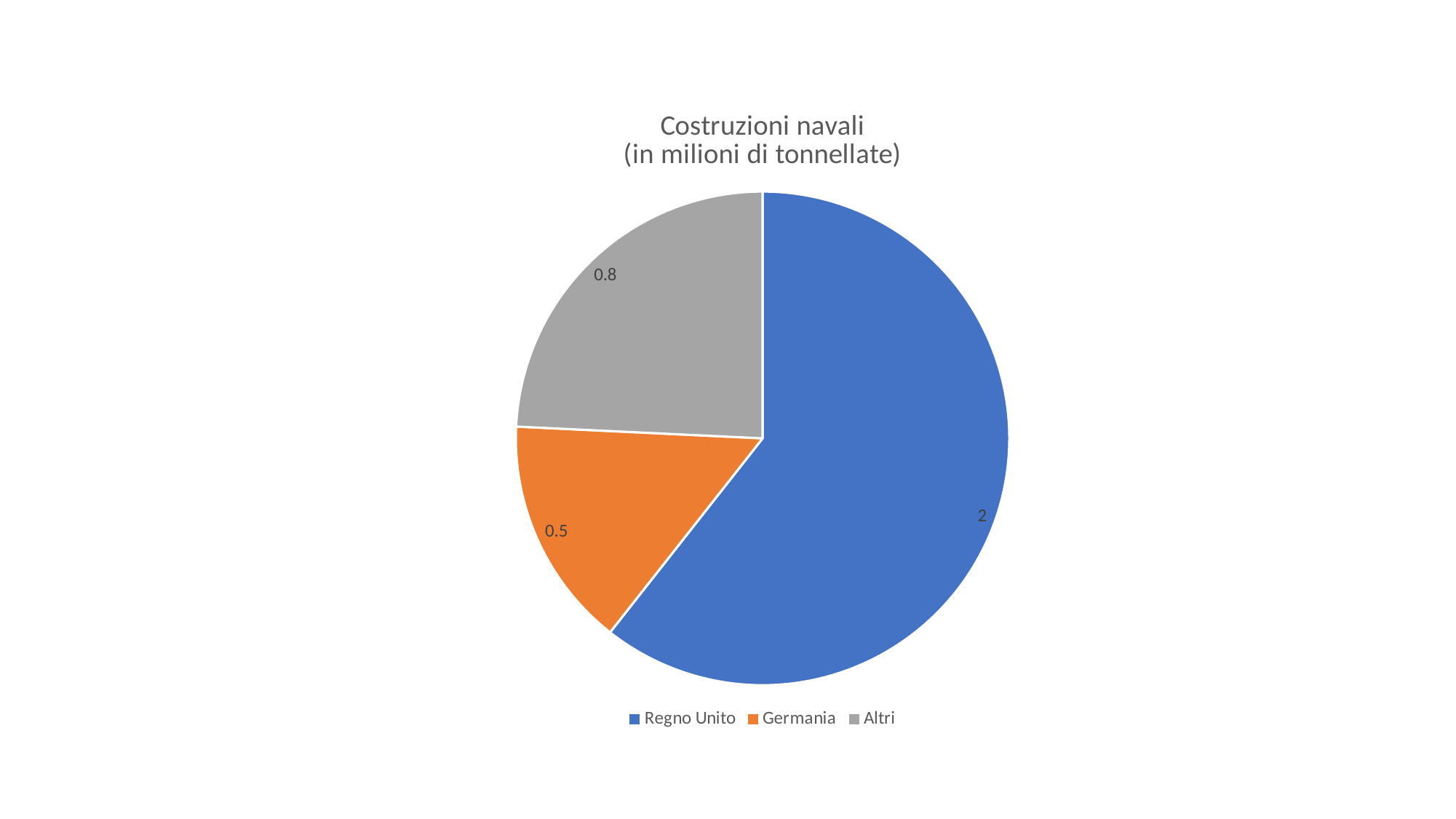
What is the total of all slices in the pie chart? 3.3 How many slices does the pie chart have? 3 Which category has the smallest slice? Germania What is the value for Altri? 0.8 What is the title of the chart? Costruzioni navali (in milioni di tonnellate) What kind of chart is shown on the slide? Pie chart What is the value for Germania? 0.5 What is the difference between the values for Altri and Germania? 0.3 Which category has the largest slice? Regno Unito What is the value for Regno Unito? 2 Which is larger, the value for Germania or the value for Altri? Altri What is the difference between the values for Regno Unito and Altri? 1.2